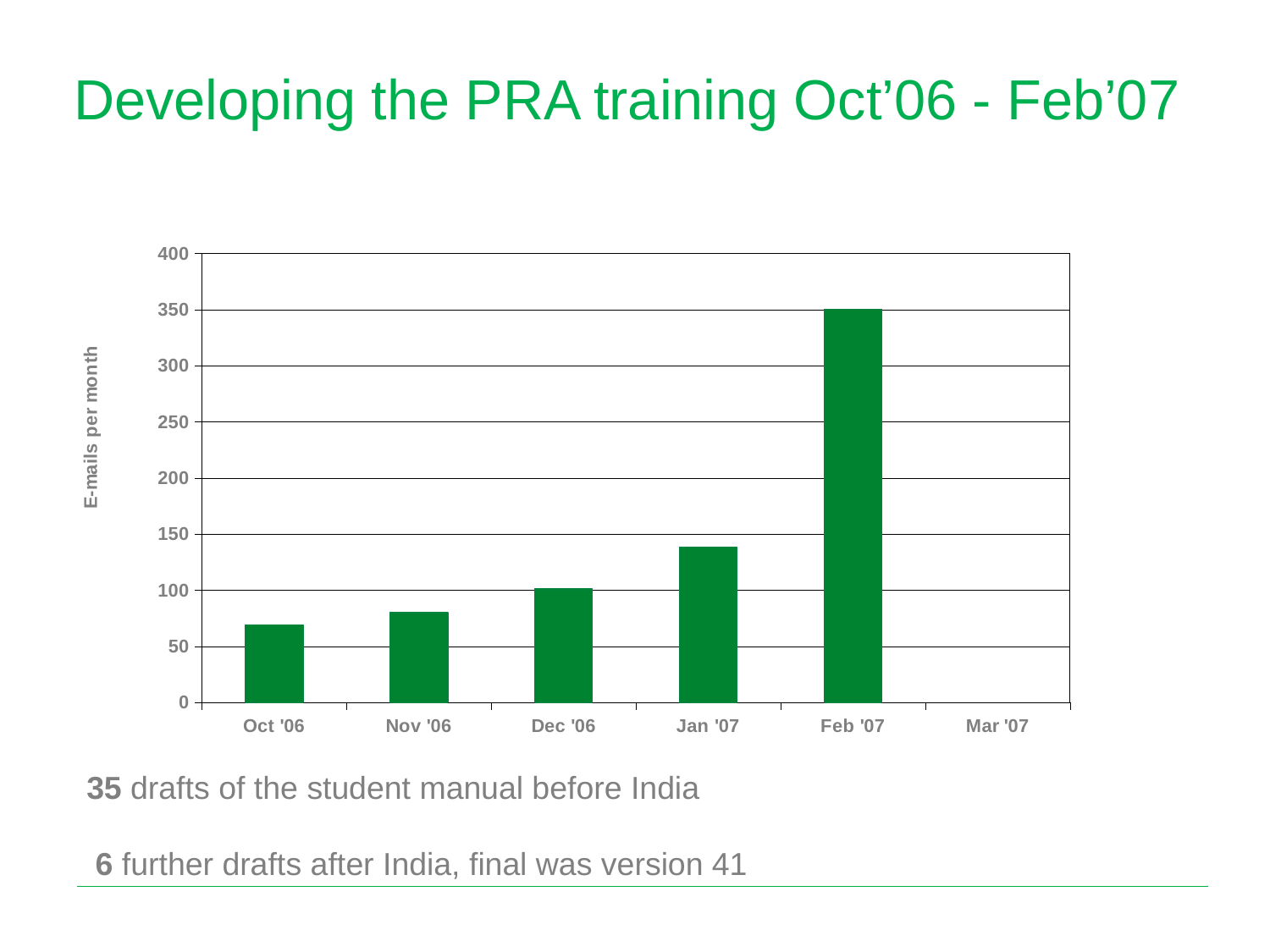
Which month has the tallest bar in the chart? Feb '07 Is the value for Feb '07 greater or less than 300? greater How many month labels are shown along the x axis of the chart? 6 Which is larger, the value for Jan '07 or the value for Dec '06? Jan '07 What kind of chart is shown on the slide? bar chart Is the value for Nov '06 greater or less than 100? less Of the months with a bar shown, which has the lowest value? Oct '06 How many bars are plotted in the chart? 5 What is the label on the vertical axis of the chart? E-mails per month Do the bar values rise or fall from Oct '06 to Feb '07? rise Is the value for Jan '07 greater or less than 150? less